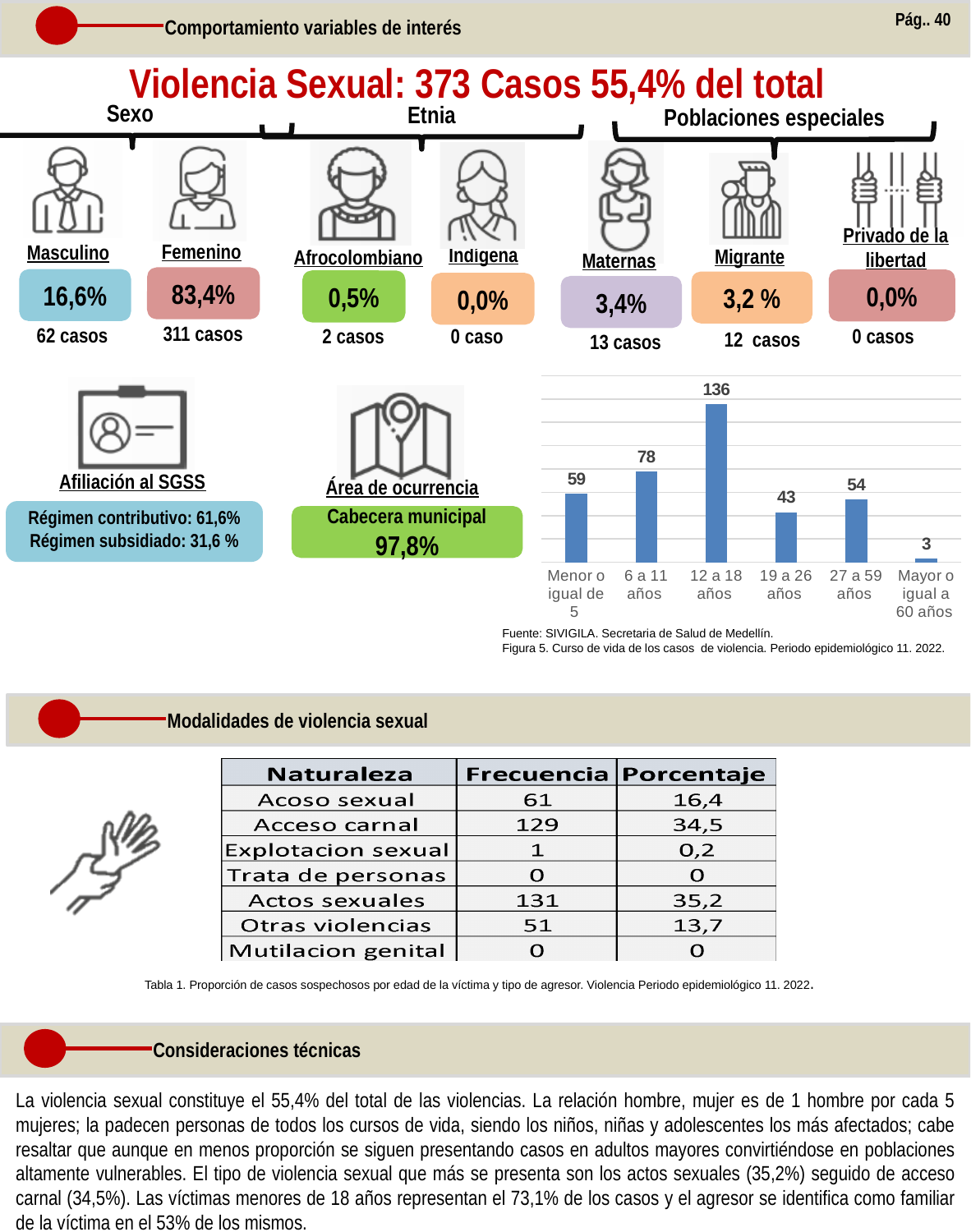
In the bar chart (Figura 5), which age category has the highest value? 12 a 18 años In the bar chart (Figura 5), what is the value for 'Mayor o igual a 60 años'? 3 In the bar chart (Figura 5), which is larger: the value for 'Menor o igual de 5' or the value for '27 a 59 años'? Menor o igual de 5 In the bar chart (Figura 5), what is the value for 'Menor o igual de 5'? 59 According to the caption, what is the source of the data in the bar chart (Figura 5)? SIVIGILA. Secretaria de Salud de Medellín. In the bar chart (Figura 5), what is the value for the '12 a 18 años' category? 136 What kind of chart is Figura 5 (Curso de vida de los casos de violencia)? Bar chart In the bar chart (Figura 5), what is the value for the '6 a 11 años' category? 78 In the bar chart (Figura 5), what is the difference between the values for '12 a 18 años' and '6 a 11 años'? 58 How many age categories are shown in the bar chart (Figura 5)? 6 In the bar chart (Figura 5), which age category has the lowest value? Mayor o igual a 60 años In the bar chart (Figura 5), what is the difference between the values for '27 a 59 años' and '19 a 26 años'? 11